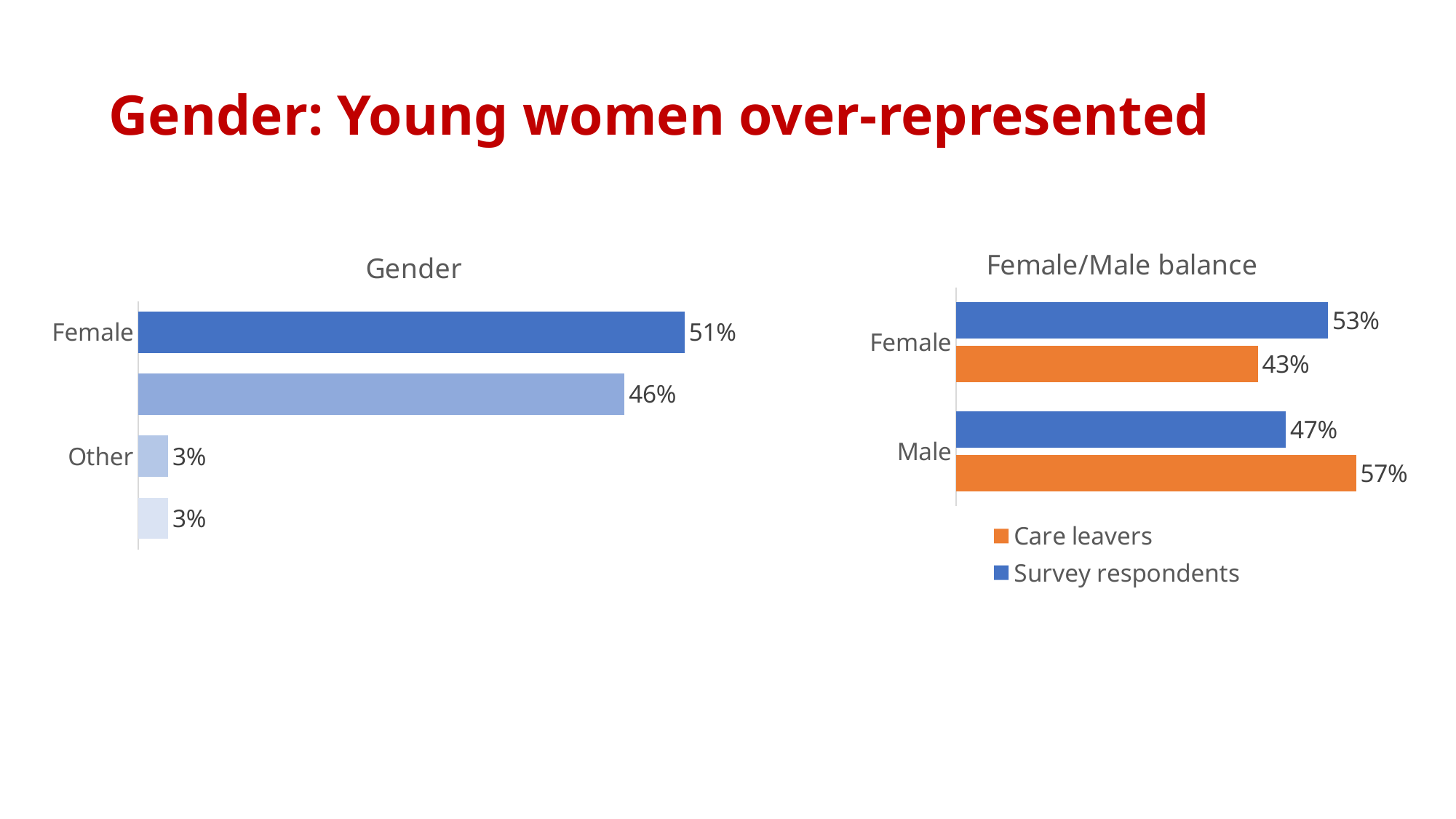
In the 'Female/Male balance' chart, what is the value for Care leavers for Female? 43% What kind of chart is the 'Gender' chart? Bar chart How many series does the legend of the 'Female/Male balance' chart list? 2 In the 'Female/Male balance' chart, what is the value for Survey respondents for Female? 53% In the 'Female/Male balance' chart, which is larger for Female: Care leavers or Survey respondents? Survey respondents In the 'Female/Male balance' chart, which colour represents Care leavers? Orange In the 'Gender' chart, what is the value labelled for Other? 3% In the 'Gender' chart, what is the value for Female? 51% In the 'Female/Male balance' chart, what is the value for Survey respondents for Male? 47% In the 'Gender' chart, which labelled category has the highest value? Female In the 'Female/Male balance' chart, what is the value for Care leavers for Male? 57% In the 'Female/Male balance' chart, what is the difference between Care leavers and Survey respondents for Male? 10%